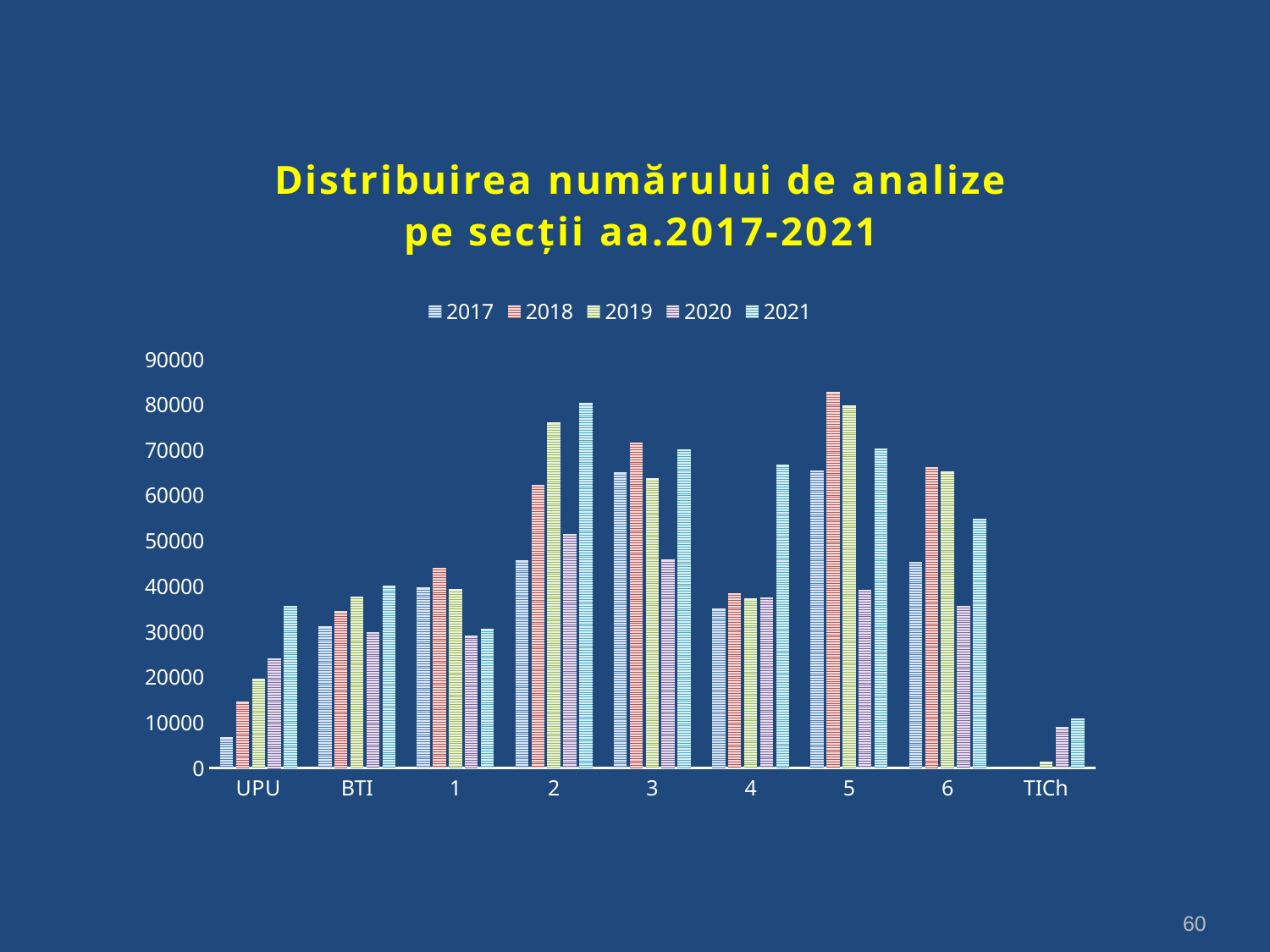
Is the 2021 value for category 4 greater or less than 60000? greater What kind of chart is shown on the slide? bar chart Which series has the highest value for category 5? 2018 Which series has the highest value for category UPU? 2021 Is the 2017 value for category UPU greater or less than 10000? less How many categories are shown on the x axis? 9 Is the 2018 value for category 5 greater or less than 80000? greater What is the title of the chart? Distribuirea numărului de analize pe secții aa.2017-2021 Which series has the lowest value for category UPU? 2017 How many series does the legend list? 5 Which is larger for category 2: the 2017 value or the 2021 value? 2021 Do the values for category UPU rise or fall from 2017 to 2021? rise